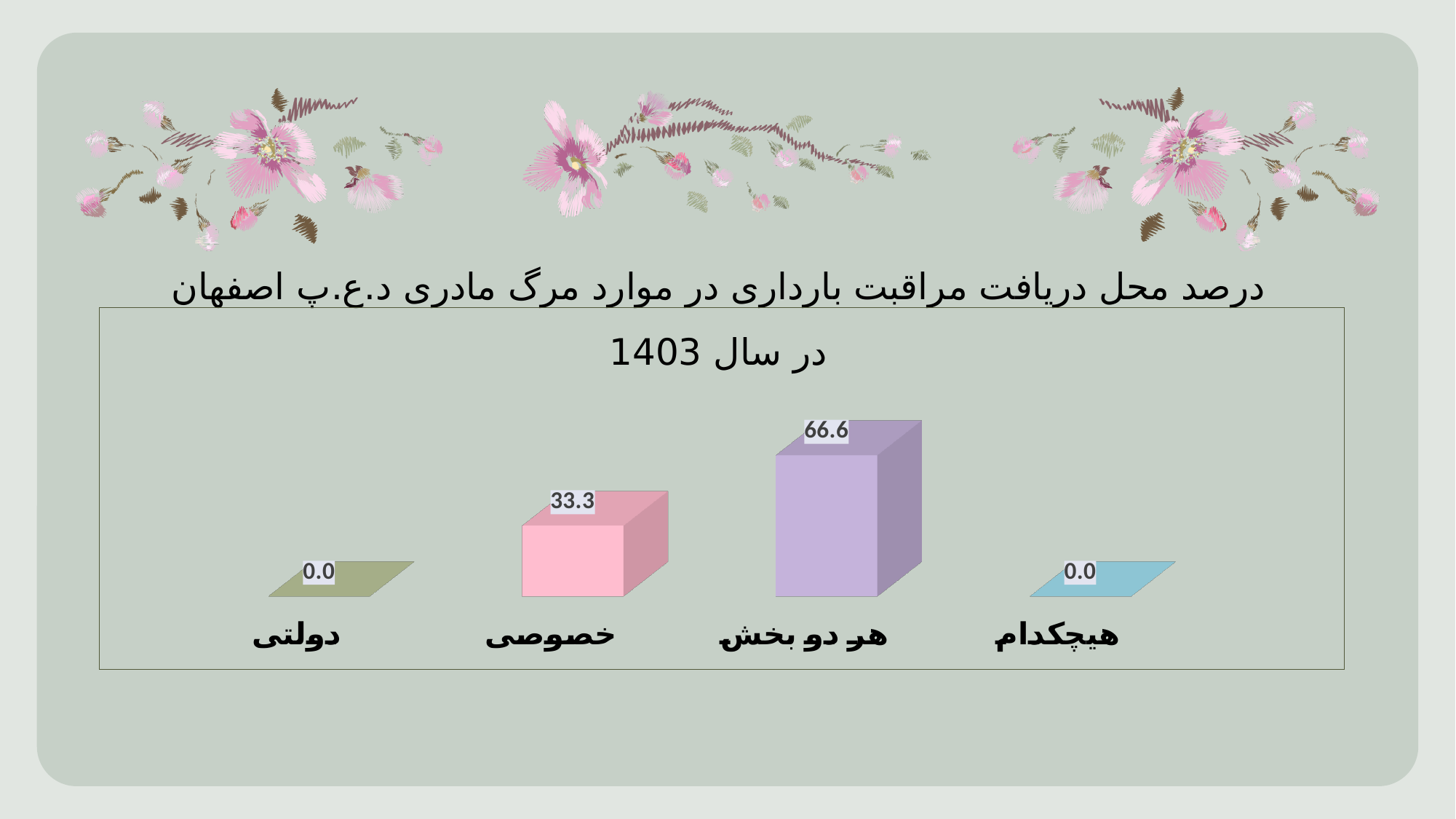
What year is mentioned in the chart title? 1403 Which is larger, the value for خصوصی or the value for هر دو بخش? هر دو بخش What is the value for خصوصی? 33.3 What colour is the bar for هر دو بخش? purple Which category has the highest value? هر دو بخش What is the value for هر دو بخش? 66.6 How many categories are shown in the chart? 4 How many categories have a value of 0.0? 2 What is the difference between the values for هر دو بخش and خصوصی? 33.3 What is the value for دولتی? 0.0 What is the value for هیچکدام? 0.0 What kind of chart is shown on the slide? bar chart